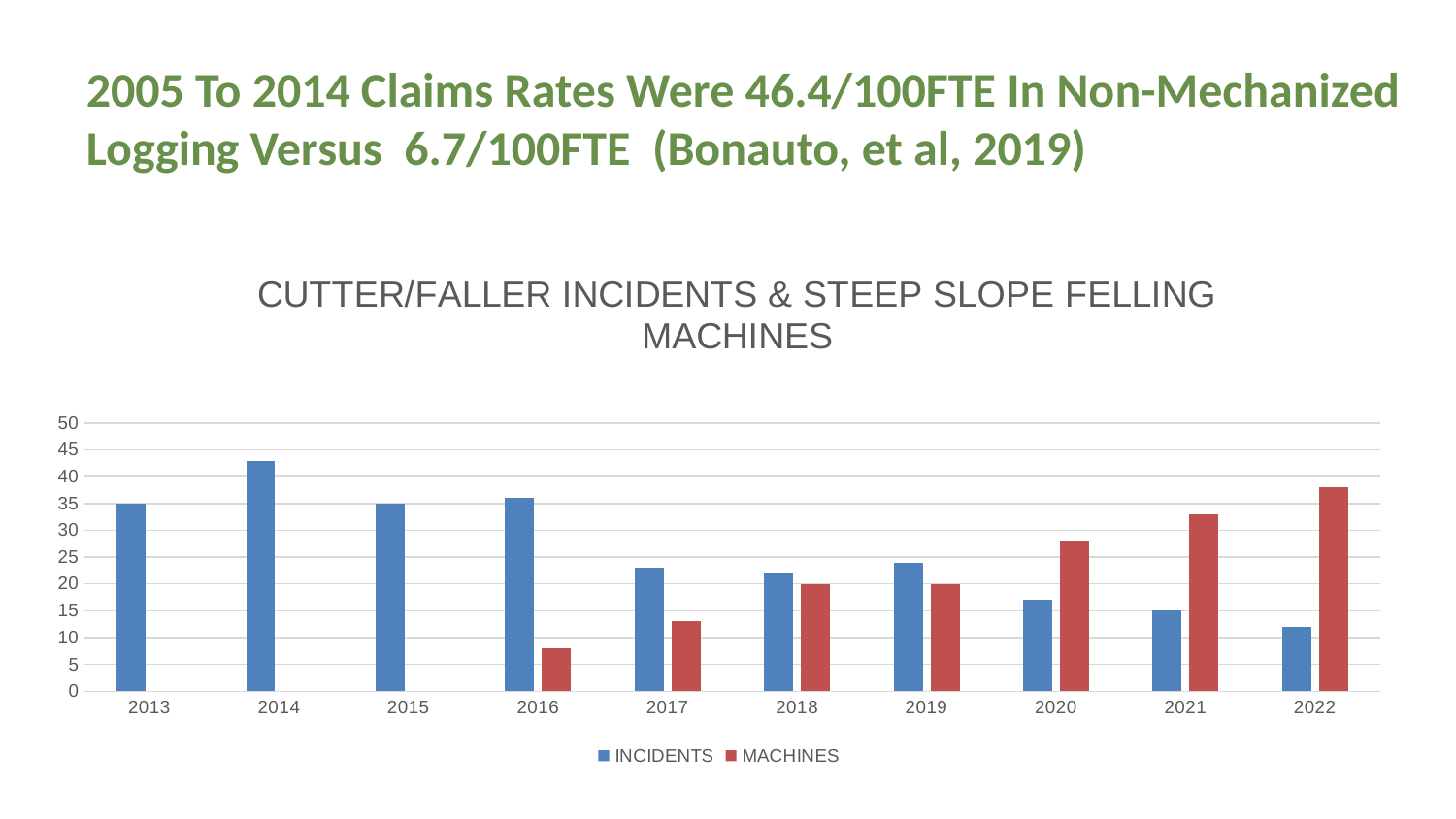
How many series does the legend list? 2 Which year has the lowest INCIDENTS value? 2022 Which year has the highest MACHINES value? 2022 Is the INCIDENTS value for 2014 greater or less than 40? greater What type of chart is shown on the slide? Bar chart Is the MACHINES value for 2016 greater or less than 10? less In 2022, which is larger, INCIDENTS or MACHINES? MACHINES In 2017, which is larger, INCIDENTS or MACHINES? INCIDENTS How many years are shown on the x axis? 10 Which year has the highest INCIDENTS value? 2014 Do the MACHINES values rise or fall from 2016 to 2022? rise Is the MACHINES value for 2021 greater or less than 30? greater